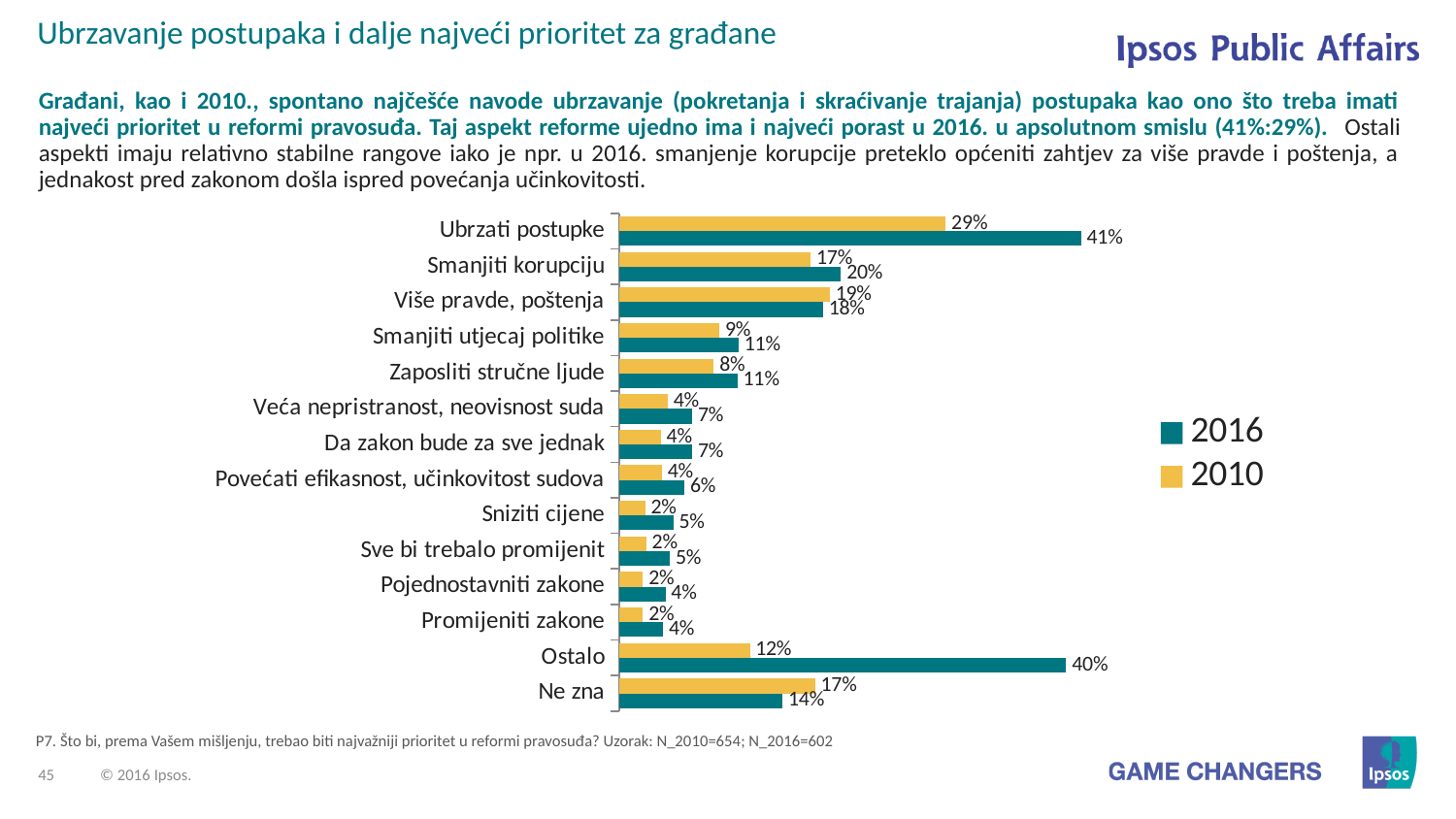
What is the difference between the 2016 and 2010 values for "Ostalo"? 28% What is the 2010 value for "Ubrzati postupke"? 29% What is the difference between the 2016 and 2010 values for "Ubrzati postupke"? 12% How many series does the legend list? 2 How many categories are shown on the chart? 14 What is the 2016 value for "Ubrzati postupke"? 41% What is the 2010 value for "Ne zna"? 17% Which is larger for "Više pravde, poštenja": the 2016 value or the 2010 value? 2010 Which category has the highest 2010 value? Ubrzati postupke What kind of chart is shown on the slide? bar chart Which colour represents the 2010 series in the legend? yellow What is the 2016 value for "Ostalo"? 40%